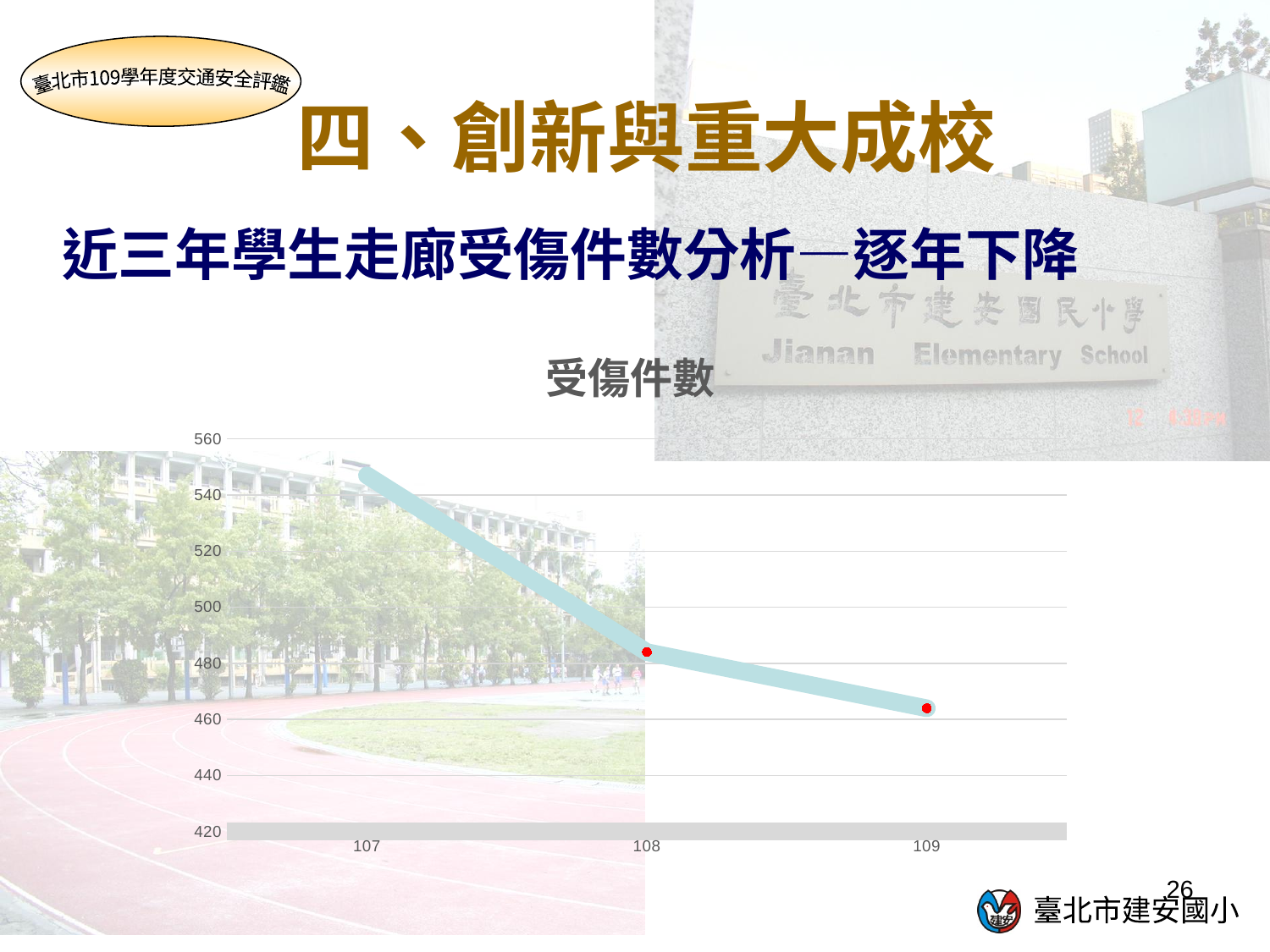
Which year has the lowest value in the chart? 109 What kind of chart is shown on the slide? line chart Is the value for 108 greater or less than 500? less What is the lowest value shown on the y axis of the chart? 420 Is the value for 107 greater or less than 540? greater Is the value for 109 greater or less than 460? greater Which is larger, the value for 108 or the value for 109? 108 Do the values in the chart rise or fall from 107 to 109? fall Which year has the highest value in the chart? 107 What is the title of the chart? 受傷件數 How many years (data points) are plotted on the x axis of the chart? 3